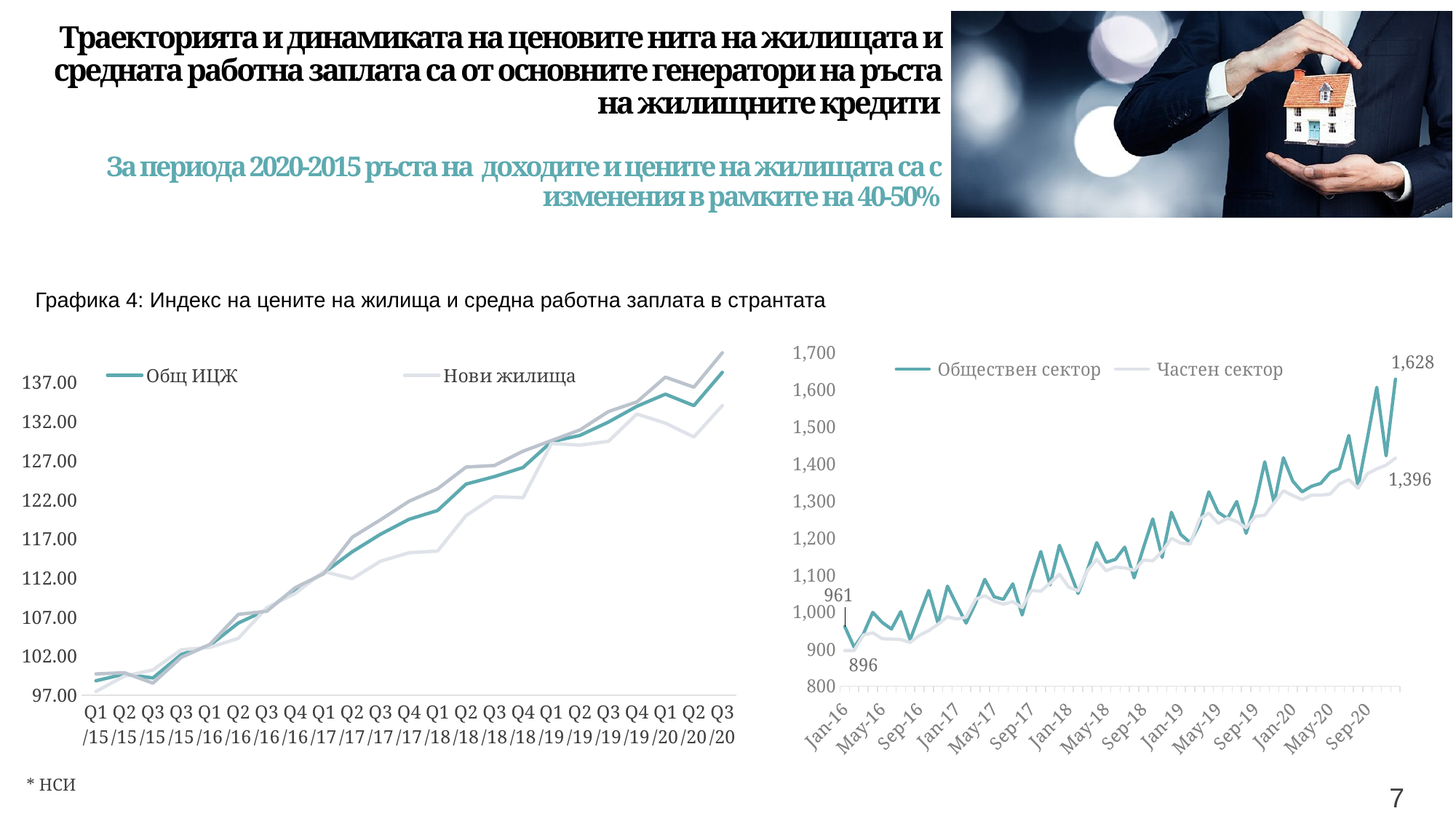
On the right-hand chart, which series ends higher at the last point, Обществен сектор or Частен сектор? Обществен сектор On the right-hand chart, what is the difference between the final labelled values of Обществен сектор (1,628) and Частен сектор (1,396)? 232 On the left-hand chart, is the value of Общ ИЦЖ at Q3/20 greater or less than 132.00? greater How many series does the legend of the right-hand chart list? 2 On the right-hand chart, do the values generally rise or fall from Jan-16 to Sep-20? rise On the right-hand chart, what is the final labelled value of the Обществен сектор series? 1,628 What kind of chart is the right-hand chart (Обществен сектор / Частен сектор)? line chart On the right-hand chart, what is the first labelled value of the Частен сектор series at Jan-16? 896 How many quarterly categories are shown on the x axis of the left-hand chart? 23 On the right-hand chart, what is the first labelled value of the Обществен сектор series at Jan-16? 961 On the left-hand chart (Общ ИЦЖ / Нови жилища), do the values generally rise or fall from Q1/15 to Q3/20? rise On the right-hand chart, what is the final labelled value of the Частен сектор series? 1,396